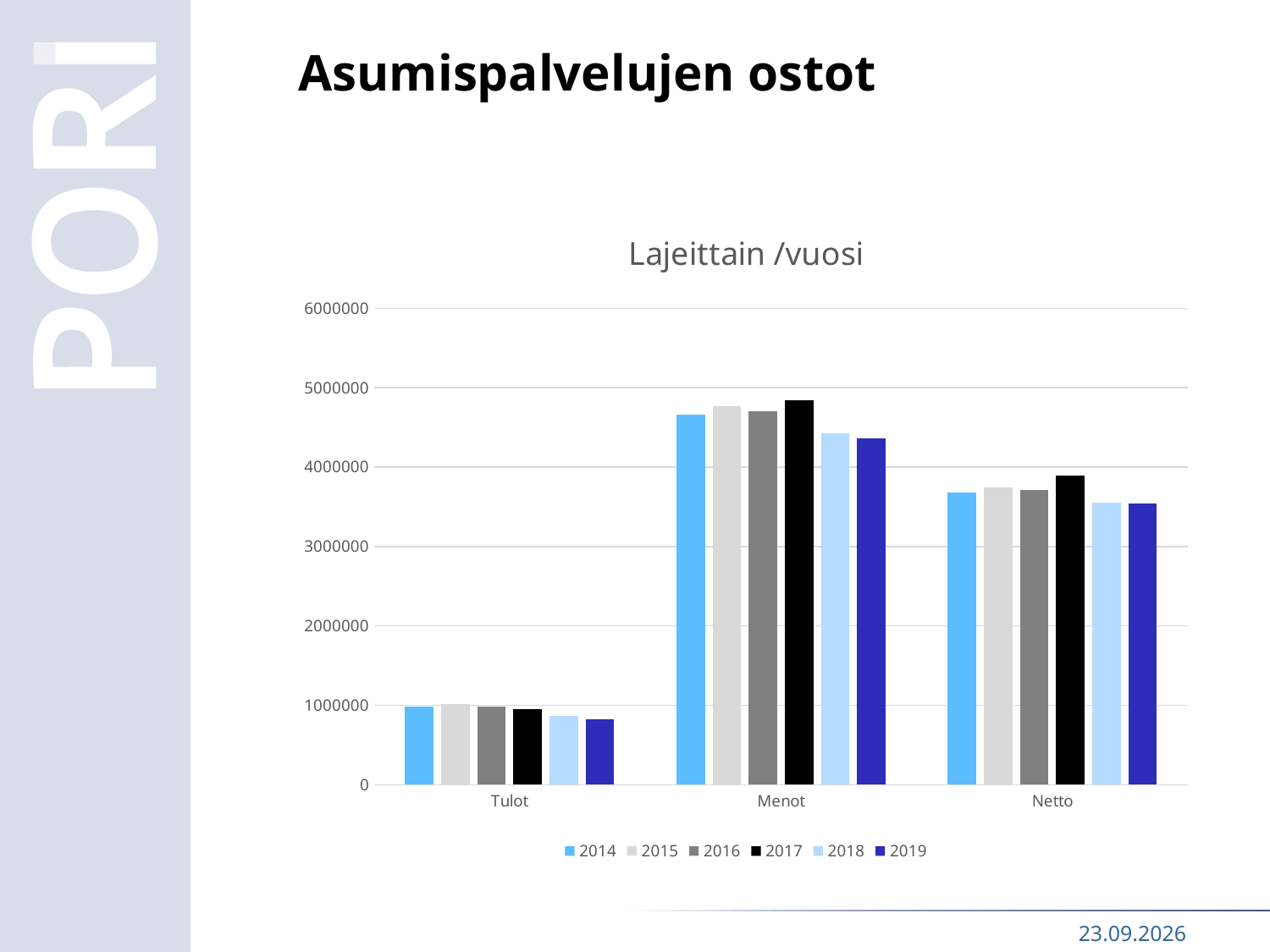
What kind of chart is shown on the slide? bar chart Is the value for Menot in 2017 greater or less than 4000000? greater Is the value for Menot in 2018 greater or less than 4000000? greater What is the title of the chart? Lajeittain /vuosi Which year has the highest value for Netto? 2017 How many series does the legend list? 6 Is the value for Tulot in 2019 greater or less than 1000000? less Which category has the tallest bars overall? Menot Which is larger for 2014: Tulot or Menot? Menot How many categories are shown on the x axis? 3 Which year has the highest value for Menot? 2017